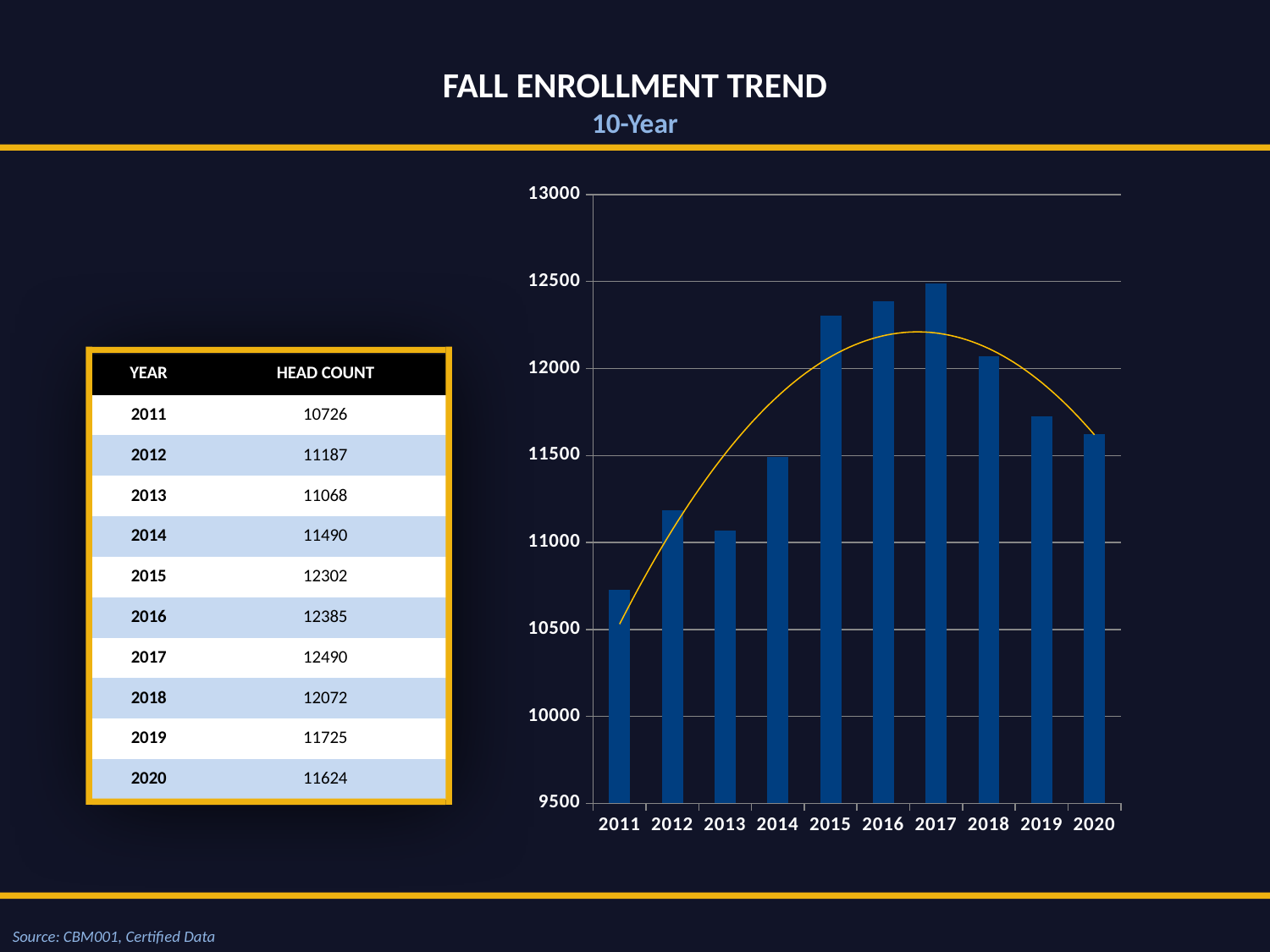
Do the values rise or fall from 2017 to 2020? Fall How many years are plotted on the x axis of the chart? 10 Which year has a larger head count, 2015 or 2019? 2015 Is the value for 2014 greater or less than 11000? greater What type of chart is shown on the slide? Bar chart Which year has the highest head count? 2017 Which year has the lowest head count? 2011 Is the value for 2018 greater or less than 12500? less What is the title of the slide's chart? Fall Enrollment Trend What is the head count for 2017? 12490 What is the difference in head count between 2017 and 2011? 1764 What is the head count for 2020? 11624